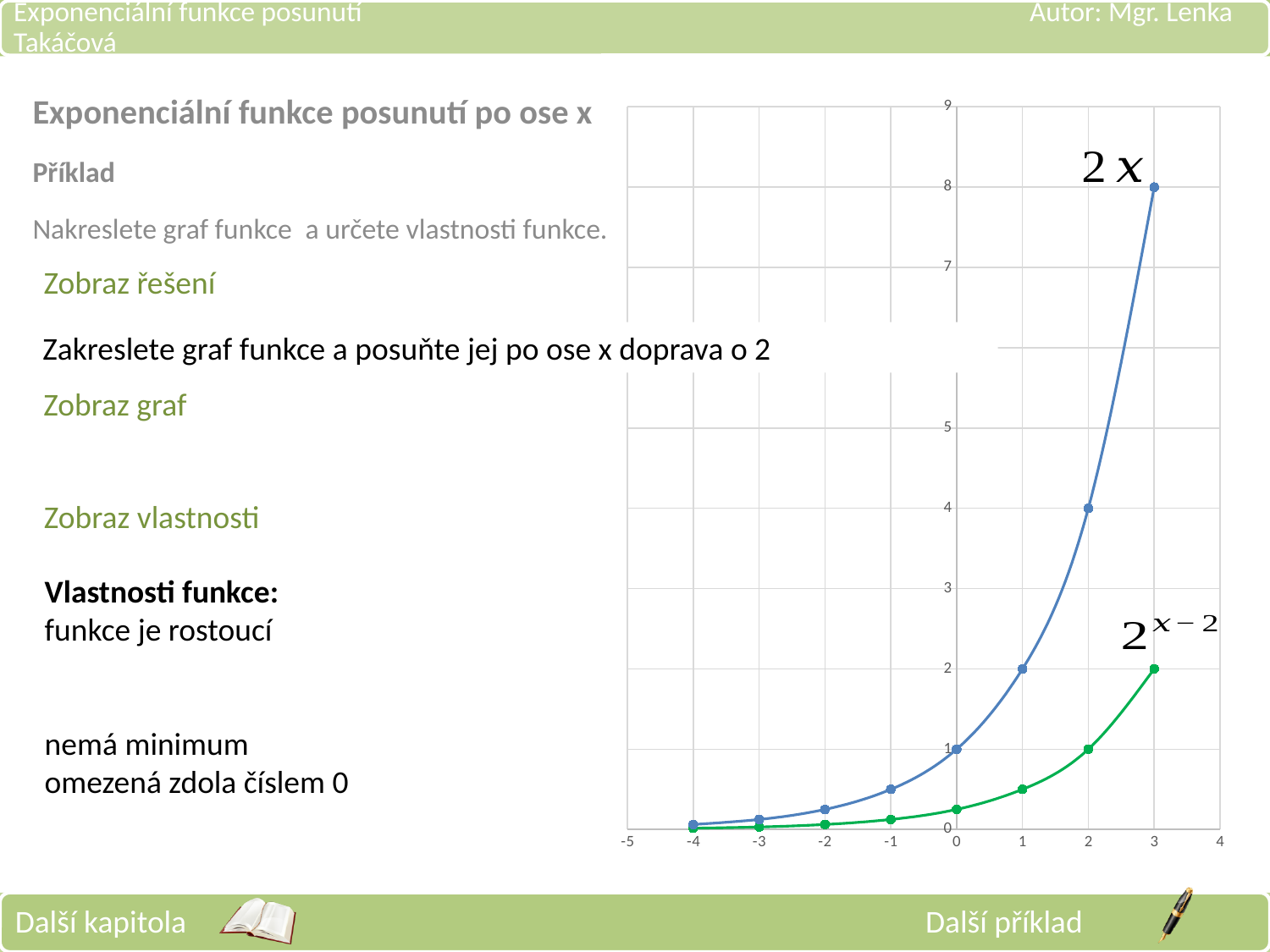
Is the value of the 2^(x-2) curve at x = 1 greater or less than 1? less Do the values of the curves rise or fall as x increases? rise At x = 2, which curve has the larger value, 2^x or 2^(x-2)? 2^x At which x value does the 2^x curve reach its highest plotted point? 3 What is the value of the 2^x curve at x = 3? 8 What is the difference between the 2^x curve and the 2^(x-2) curve at x = 3? 6 How many data points are plotted on the 2^x curve? 8 What is the value of the 2^x curve at x = 0? 1 What is the value of the 2^(x-2) curve at x = 2? 1 What is the value of the 2^(x-2) curve at x = 3? 2 What kind of chart is shown on the slide? line chart What is the value of the 2^x curve at x = 2? 4